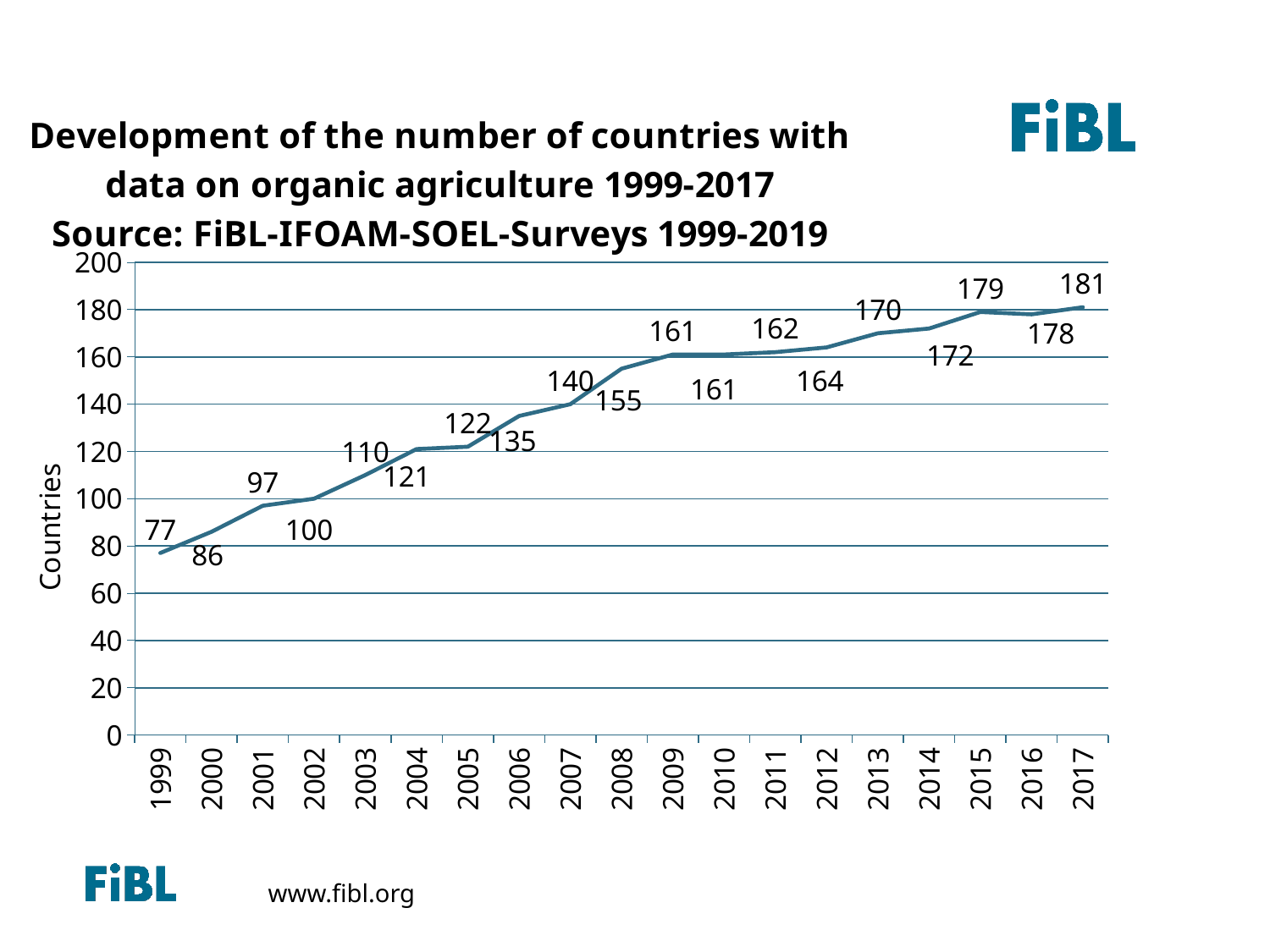
How many years (data points) are plotted on the x axis? 19 What is the value for 2004? 121 What is the difference between the values for 2017 and 1999? 104 How many countries had data on organic agriculture in 1999? 77 What is the value for 2017? 181 What kind of chart is shown on the slide? line chart Which is larger, the value for 2015 or the value for 2016? 2015 What is the label of the y axis? Countries Which year has the highest number of countries? 2017 Which year has the lowest number of countries? 1999 Do the values generally rise or fall from 1999 to 2017? rise What is the value for 2008? 155